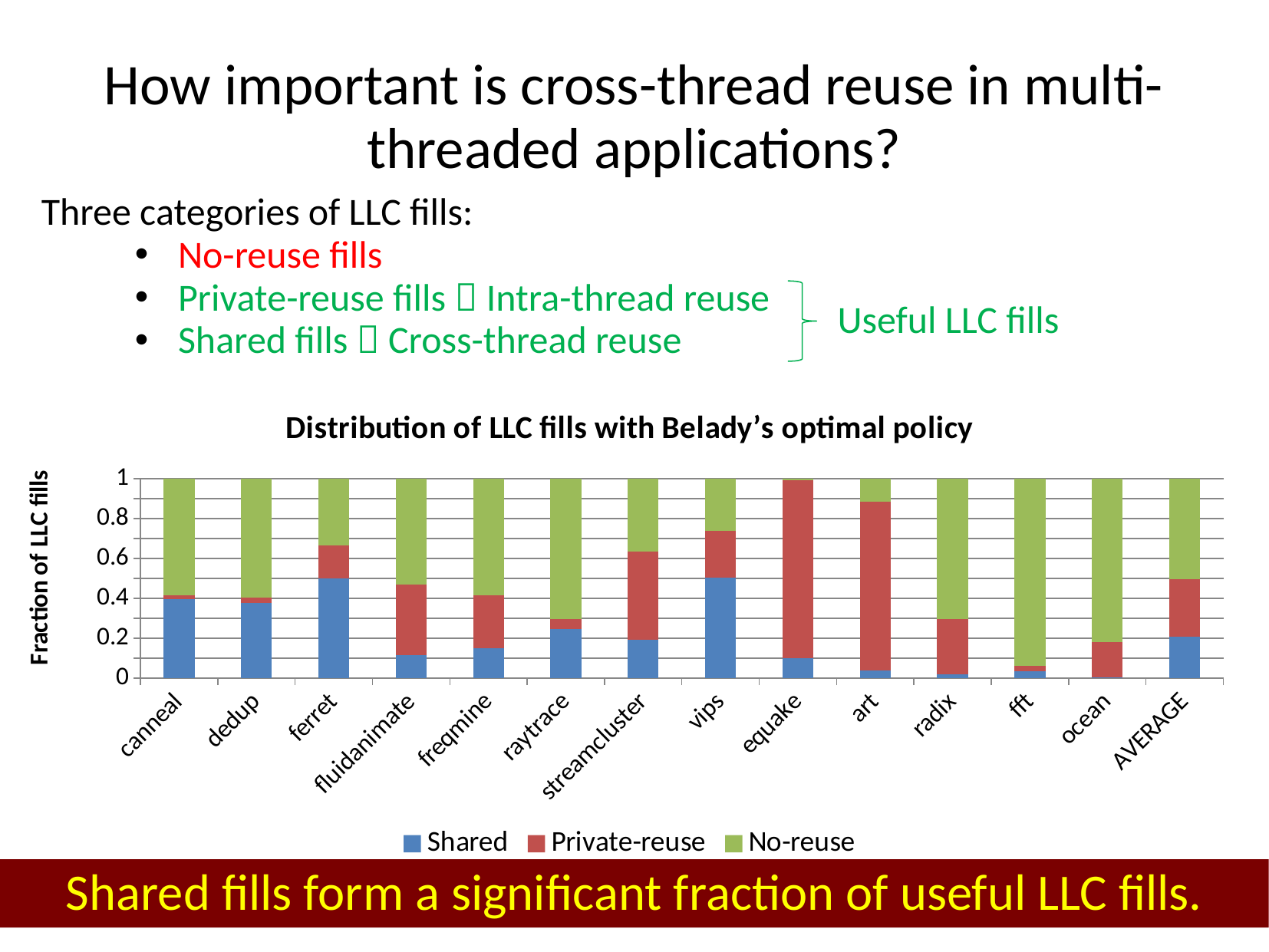
What kind of chart is shown on the slide? stacked bar chart Is the Shared value for ferret greater or less than 0.4? greater How many series does the chart legend list? 3 What is the title of the chart? Distribution of LLC fills with Belady's optimal policy Which category has the smallest No-reuse fraction? equake How many categories are shown along the x axis of the chart? 14 Which is larger, the Shared value for vips or the Shared value for fft? vips Is the Shared value for fluidanimate greater or less than 0.2? less Which category has the smallest Shared fraction? ocean Which category has the largest No-reuse fraction? fft What is the total height of the stacked bar for canneal? 1 What is the label of the y axis of the chart? Fraction of LLC fills